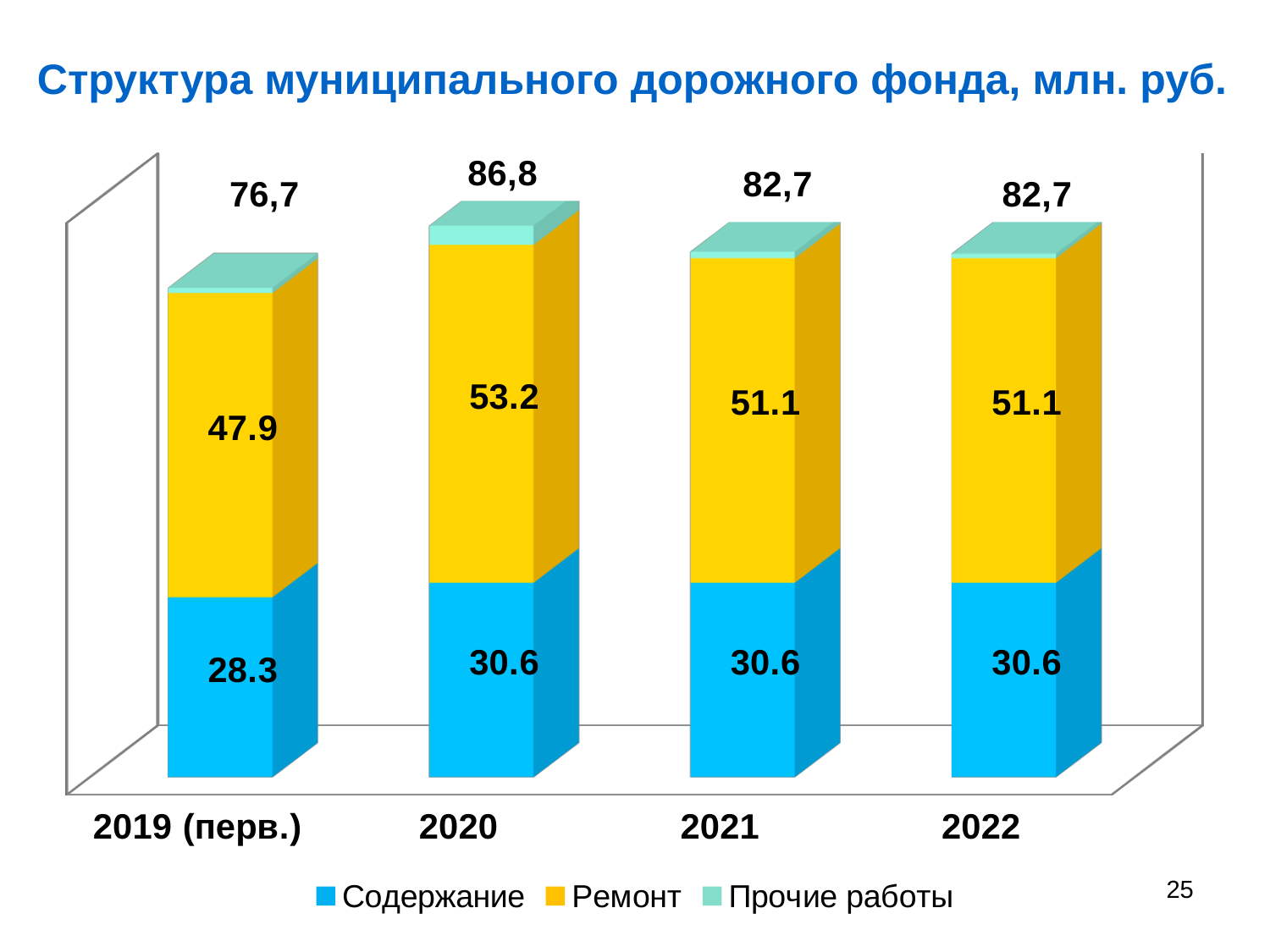
Which year has the highest total? 2020 How many series does the legend list? 3 How many years are shown on the x axis? 4 What is the value of Содержание for 2019 (перв.)? 28.3 Which is larger, the Ремонт value for 2019 (перв.) or for 2022? 2022 What kind of chart is shown on the slide? Stacked bar chart Which year has the lowest total? 2019 (перв.) What is the total of the stacked bar for 2020? 86,8 What is the difference between the Содержание values for 2020 and 2019 (перв.)? 2.3 What is the value of Ремонт for 2020? 53.2 What is the difference between the Ремонт values for 2020 and 2021? 2.1 What is the total of the stacked bar for 2019 (перв.)? 76,7